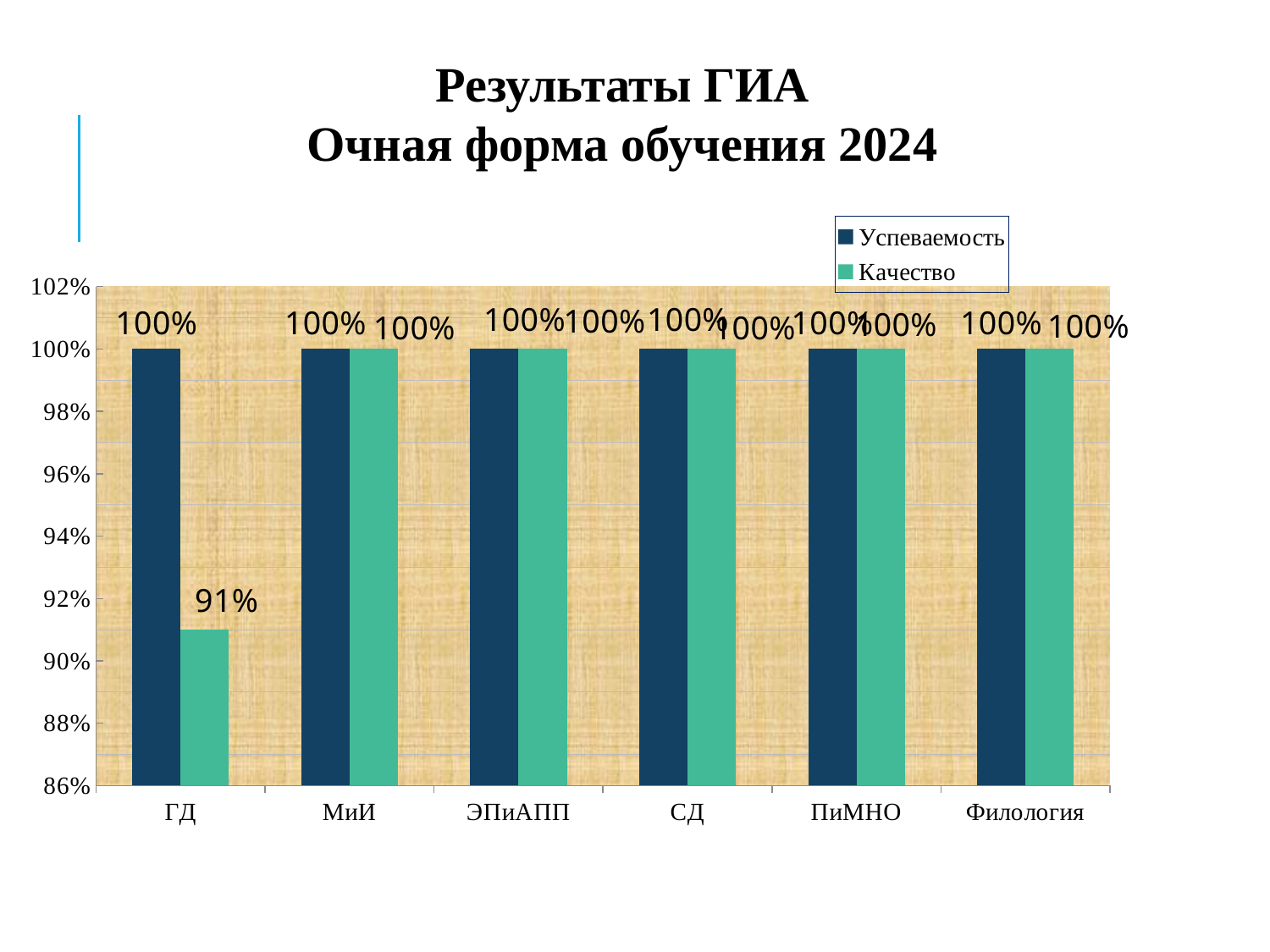
What is the Качество value for ГД? 91% What is the difference between the Успеваемость and Качество values for ГД? 9% Which series is shown in green? Качество How many categories are shown on the x axis? 6 What is the title of the chart? Результаты ГИА Очная форма обучения 2024 What kind of chart is shown on the slide? bar chart Is the Качество value for ГД greater or less than 92%? less What is the Успеваемость value for ГД? 100% Which is larger for ГД, Успеваемость or Качество? Успеваемость Which category has the lowest Качество value? ГД How many series does the legend list? 2 What is the Качество value for Филология? 100%